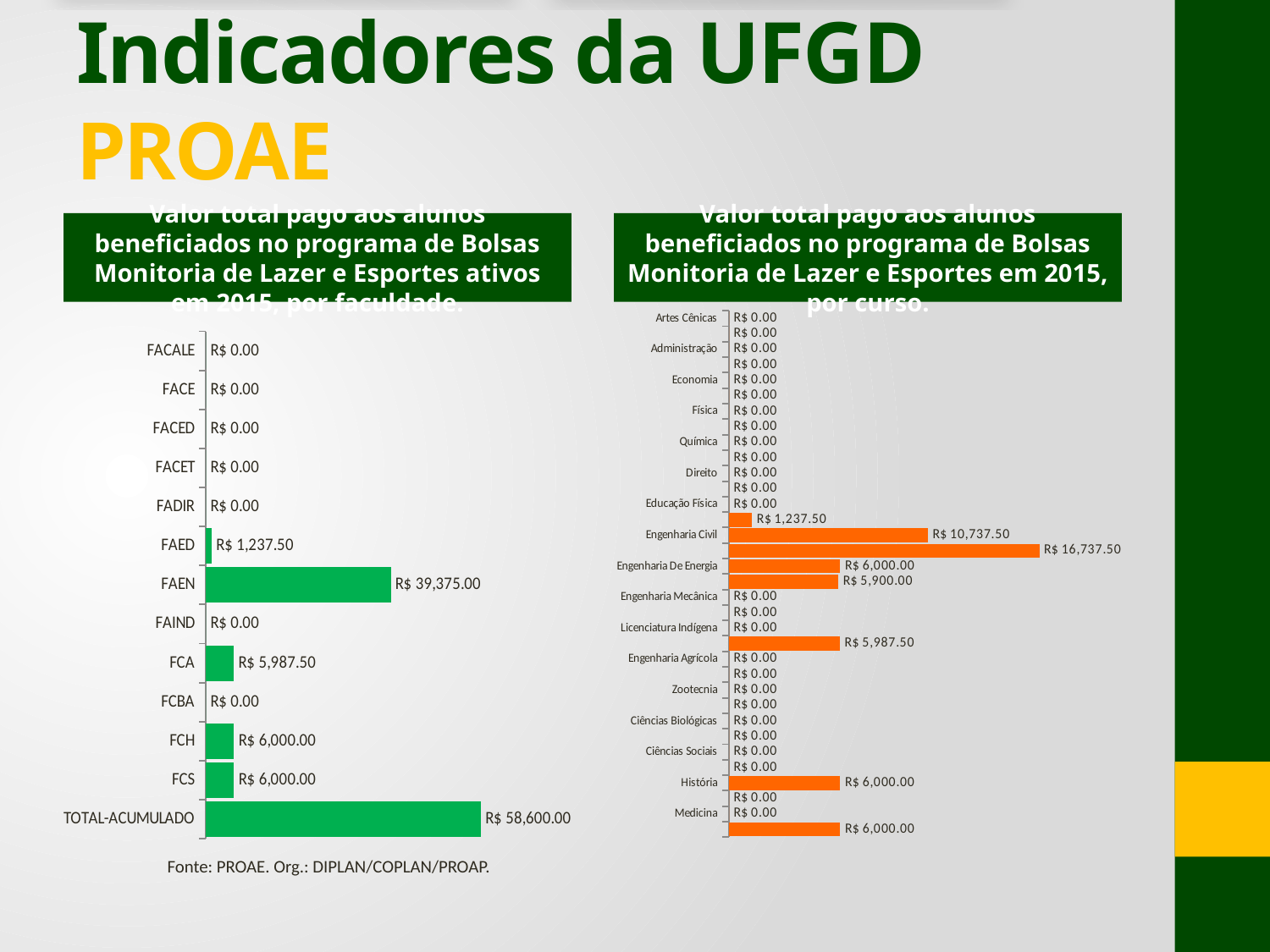
In the left chart (por faculdade), what is the value for FCA? R$ 5,987.50 What colour are the bars in the right chart (por curso)? Orange In the left chart (por faculdade), what is the value for FCH? R$ 6,000.00 In the left chart (por faculdade), what is the value for FAED? R$ 1,237.50 In the left chart (por faculdade), what is the difference between the values for FAEN and FCH? R$ 33,375.00 In the left chart (por faculdade), how many categories are shown on the axis? 13 What kind of chart is the left chart (por faculdade)? Bar chart In the left chart (por faculdade), which faculdade (excluding TOTAL-ACUMULADO) has the highest value? FAEN In the left chart (por faculdade), which is larger, the value for FCA or the value for FCS? FCS In the left chart (por faculdade), what is the value for TOTAL-ACUMULADO? R$ 58,600.00 In the left chart (por faculdade), what is the value for FAEN? R$ 39,375.00 In the right chart (por curso), what is the largest value shown? R$ 16,737.50